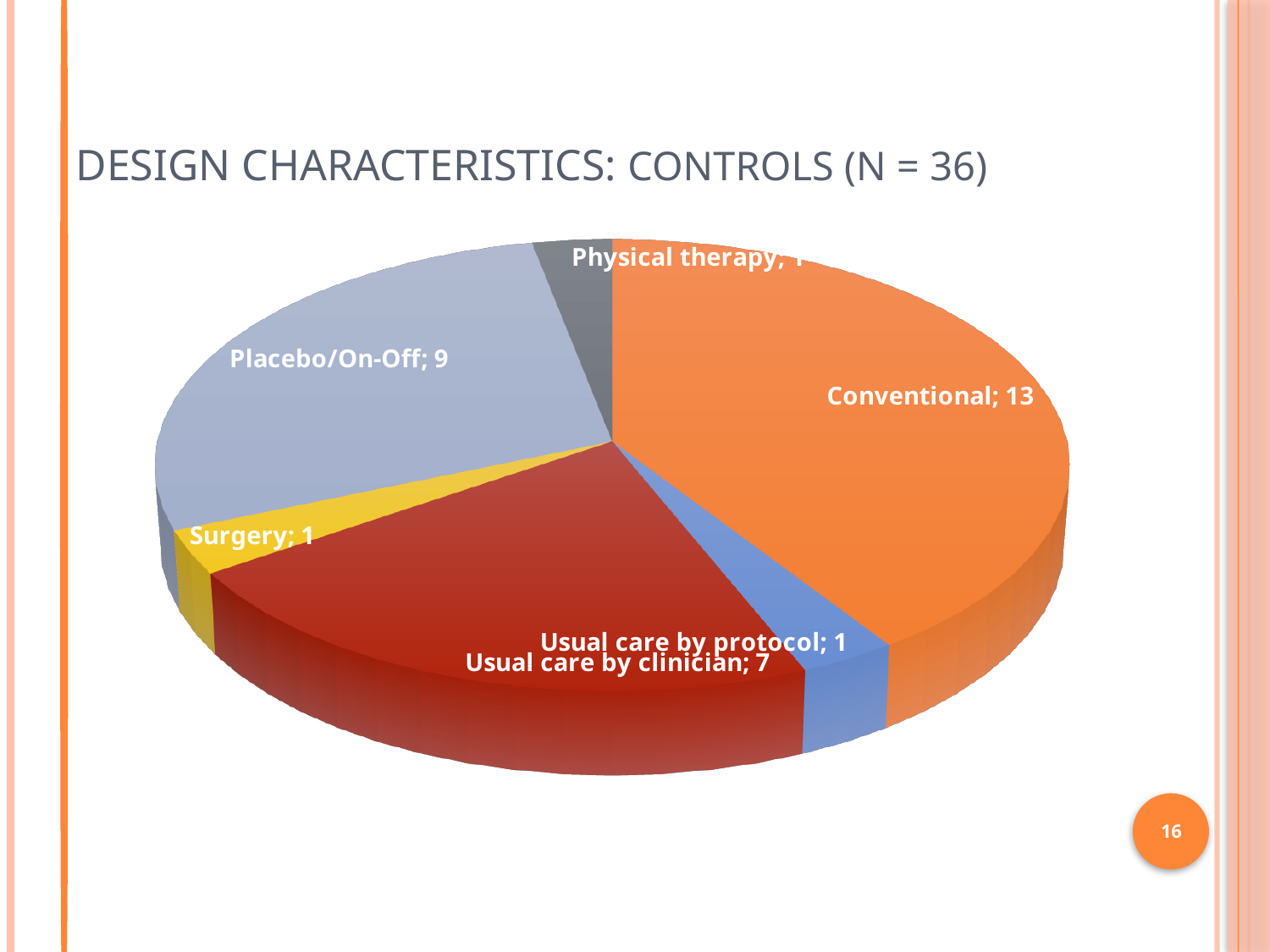
What is the value for Usual care by protocol in the pie chart? 1 What kind of chart is shown on the slide? Pie chart Which is larger, Placebo/On-Off or Usual care by clinician? Placebo/On-Off What is the value for Conventional in the pie chart? 13 What is the difference between the values for Placebo/On-Off and Usual care by clinician? 2 How many slices does the pie chart have? 6 What is the value for Placebo/On-Off in the pie chart? 9 Which category has the largest slice in the pie chart? Conventional What is the value for Surgery in the pie chart? 1 What is the value for Usual care by clinician in the pie chart? 7 What is the difference between the values for Conventional and Placebo/On-Off? 4 What is the title of the slide containing the chart? DESIGN CHARACTERISTICS: CONTROLS (N = 36)